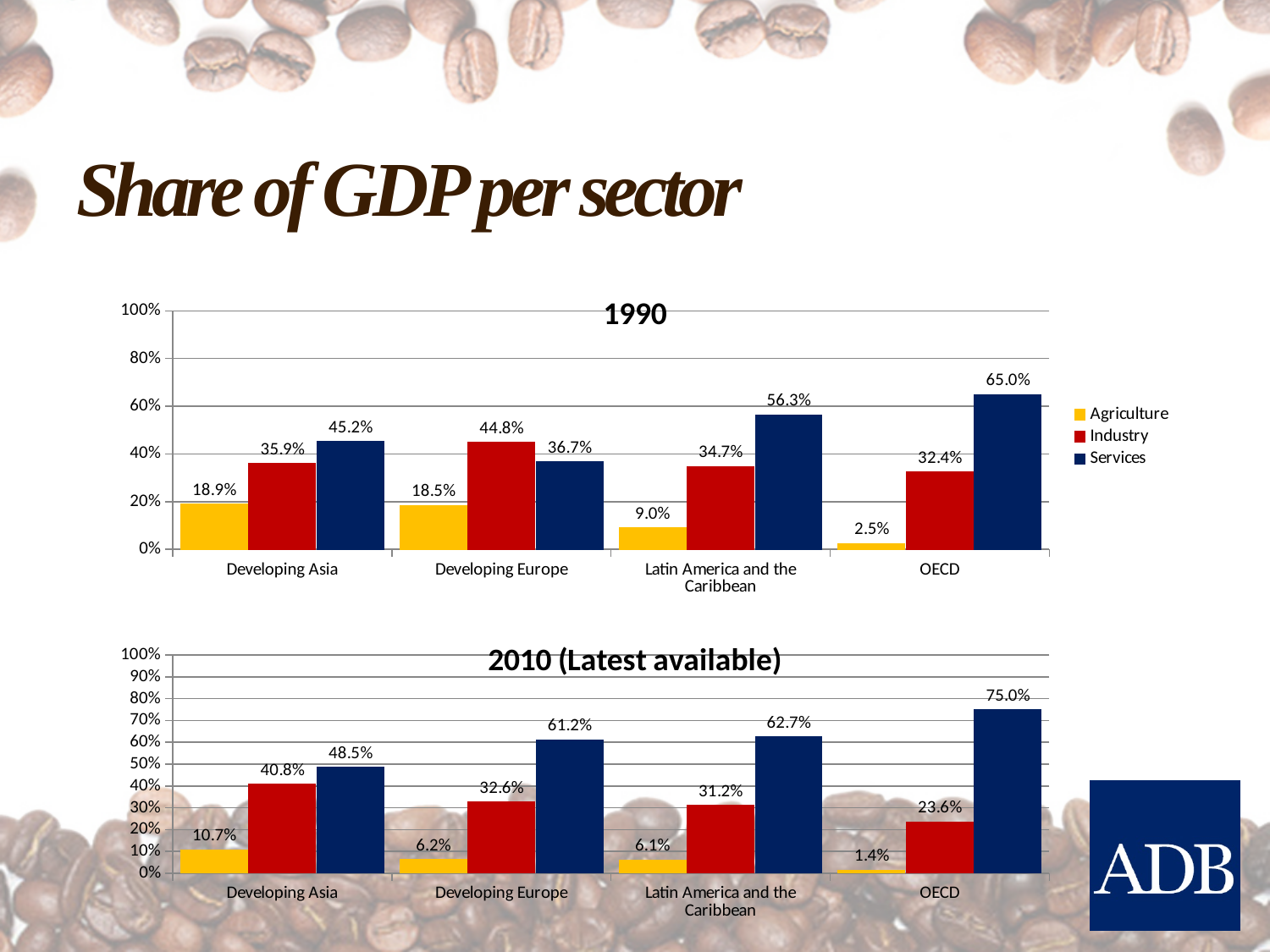
In the 1990 chart, what is the difference between the Services share and the Industry share for Latin America and the Caribbean? 21.6% In the 2010 (Latest available) chart, what is the Agriculture share of GDP for Developing Asia? 10.7% In the 1990 chart, which is larger for Developing Europe: the Industry share or the Services share? Industry How many series does the legend of the 1990 chart list? 3 In the 2010 (Latest available) chart, which region has the highest Services share? OECD In the 2010 (Latest available) chart, which is larger for Developing Europe: the Industry share or the Services share? Services In the 1990 chart, what is the Services share of GDP for OECD? 65.0% What type of chart is the 2010 (Latest available) chart? Bar chart In the 1990 chart, what is the Industry share of GDP for Developing Europe? 44.8% In the 2010 (Latest available) chart, what is the difference between the Services share for OECD and the Services share for Developing Asia? 26.5% How many regions are shown on the x axis of the 2010 (Latest available) chart? 4 In the 1990 chart, which region has the lowest Agriculture share? OECD